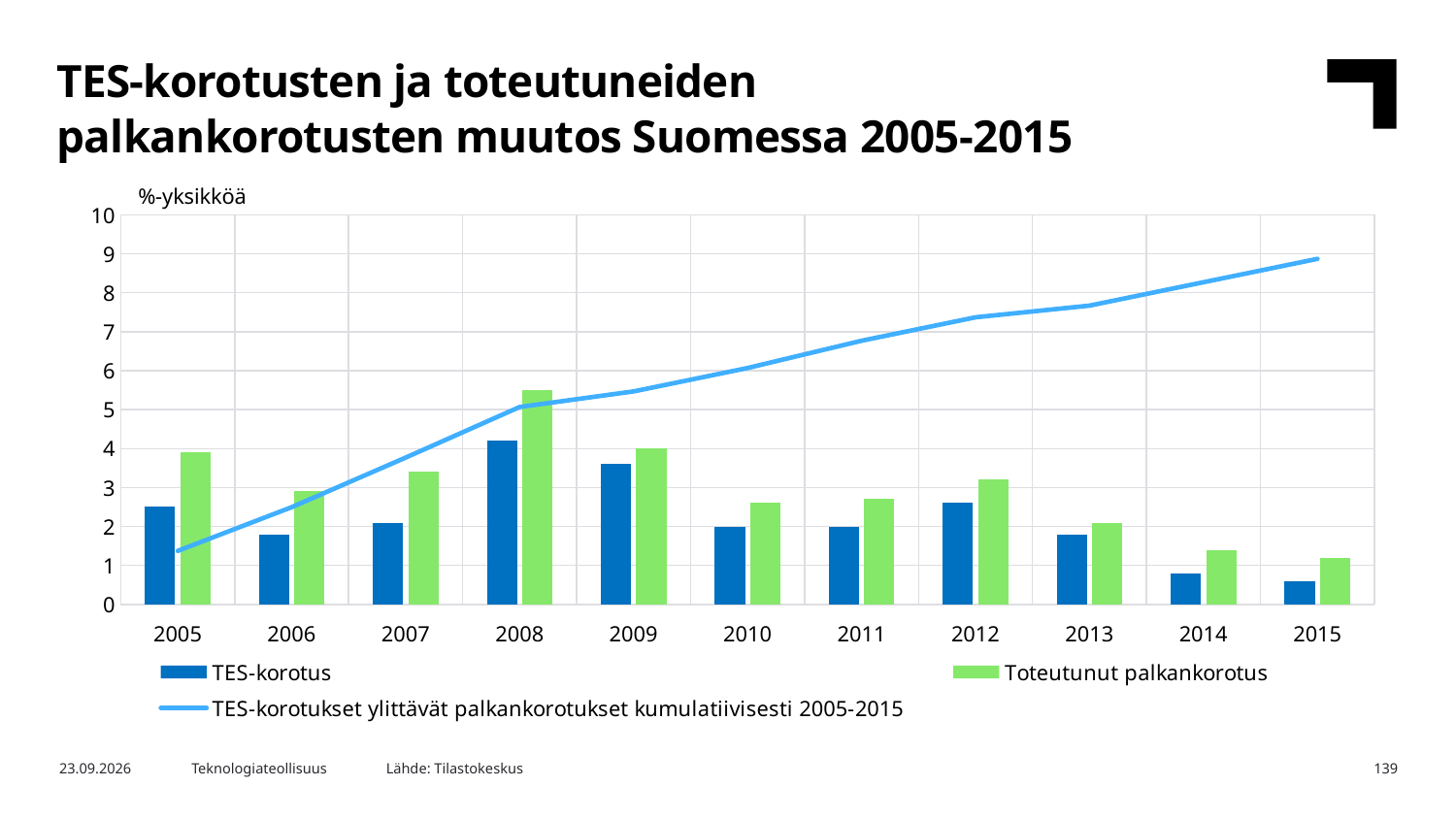
In which year is the TES-korotus bar the highest? 2008 In which year is the Toteutunut palkankorotus bar the highest? 2008 In 2005, which is larger: TES-korotus or Toteutunut palkankorotus? Toteutunut palkankorotus Does the cumulative line (TES-korotukset ylittävät palkankorotukset kumulatiivisesti 2005-2015) rise or fall from 2005 to 2015? Rises How many series does the chart legend list? 3 What unit label is shown above the y axis of the chart? %-yksikköä In which year is the TES-korotus bar the lowest? 2015 How many years are shown on the x axis of the chart? 11 What kind of chart is shown on the slide? Combined bar and line chart Is the Toteutunut palkankorotus value for 2008 greater or less than 5? greater Is the TES-korotus value for 2014 greater or less than 1? less Is the value of the cumulative line (TES-korotukset ylittävät palkankorotukset kumulatiivisesti) in 2015 greater or less than 8? greater